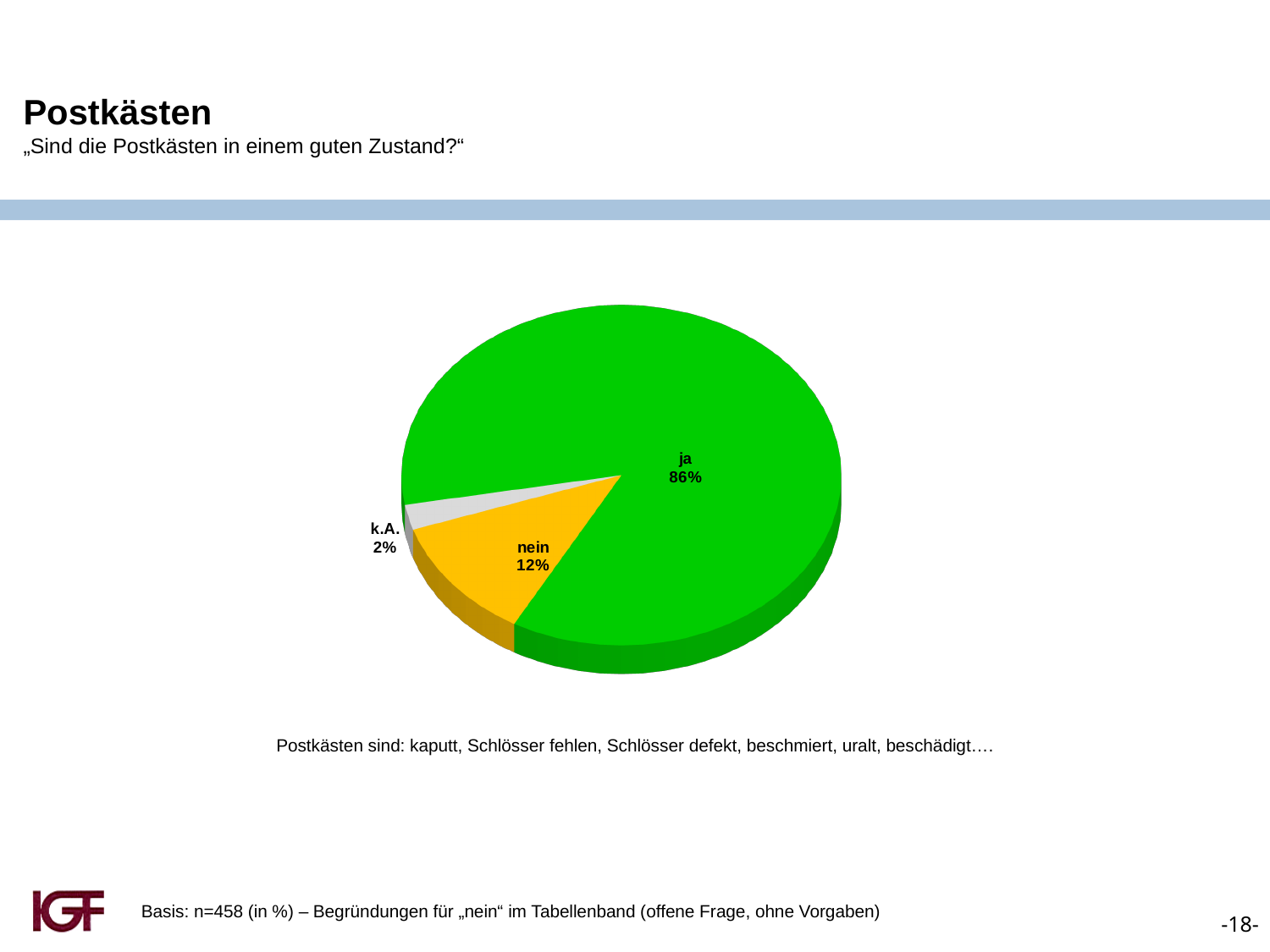
Which slice of the pie is the smallest? k.A. What is the sample size (n) stated at the bottom of the slide? n=458 What is the combined share of "nein" and "k.A."? 14% Which slice of the pie is the largest? ja What colour is the "ja" slice? green What percentage of respondents answered "ja"? 86% What percentage of respondents answered "nein"? 12% What kind of chart is shown on the slide? pie chart What is the difference in percentage points between "ja" and "nein"? 74 Which is larger, the share for "nein" or the share for "k.A."? nein What percentage is shown for "k.A."? 2% How many slices does the pie chart have? 3